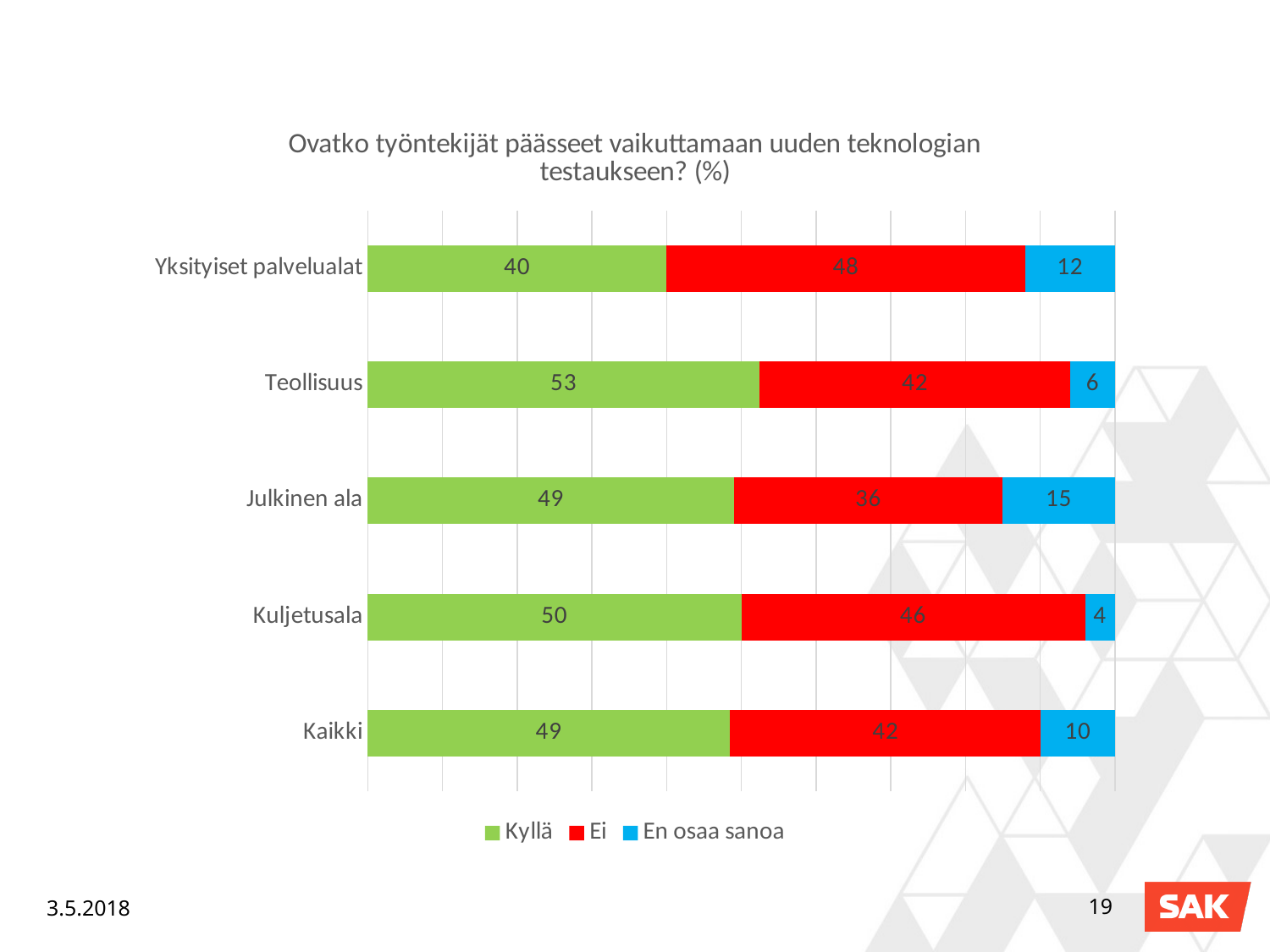
How many series does the legend list? 3 What is the "En osaa sanoa" value for Julkinen ala? 15 Which series is shown in red? Ei Which is larger: the "Kyllä" value for Kuljetusala or for Yksityiset palvelualat? Kuljetusala What is the total of the stacked bar for Kaikki? 101 What is the "Kyllä" value for Teollisuus? 53 Which category has the lowest "En osaa sanoa" value? Kuljetusala Which category has the highest "Kyllä" value? Teollisuus What kind of chart is shown on the slide? Stacked bar chart How many categories are shown on the chart? 5 What is the "Ei" value for Yksityiset palvelualat? 48 What is the difference between the "Ei" values for Yksityiset palvelualat and Julkinen ala? 12